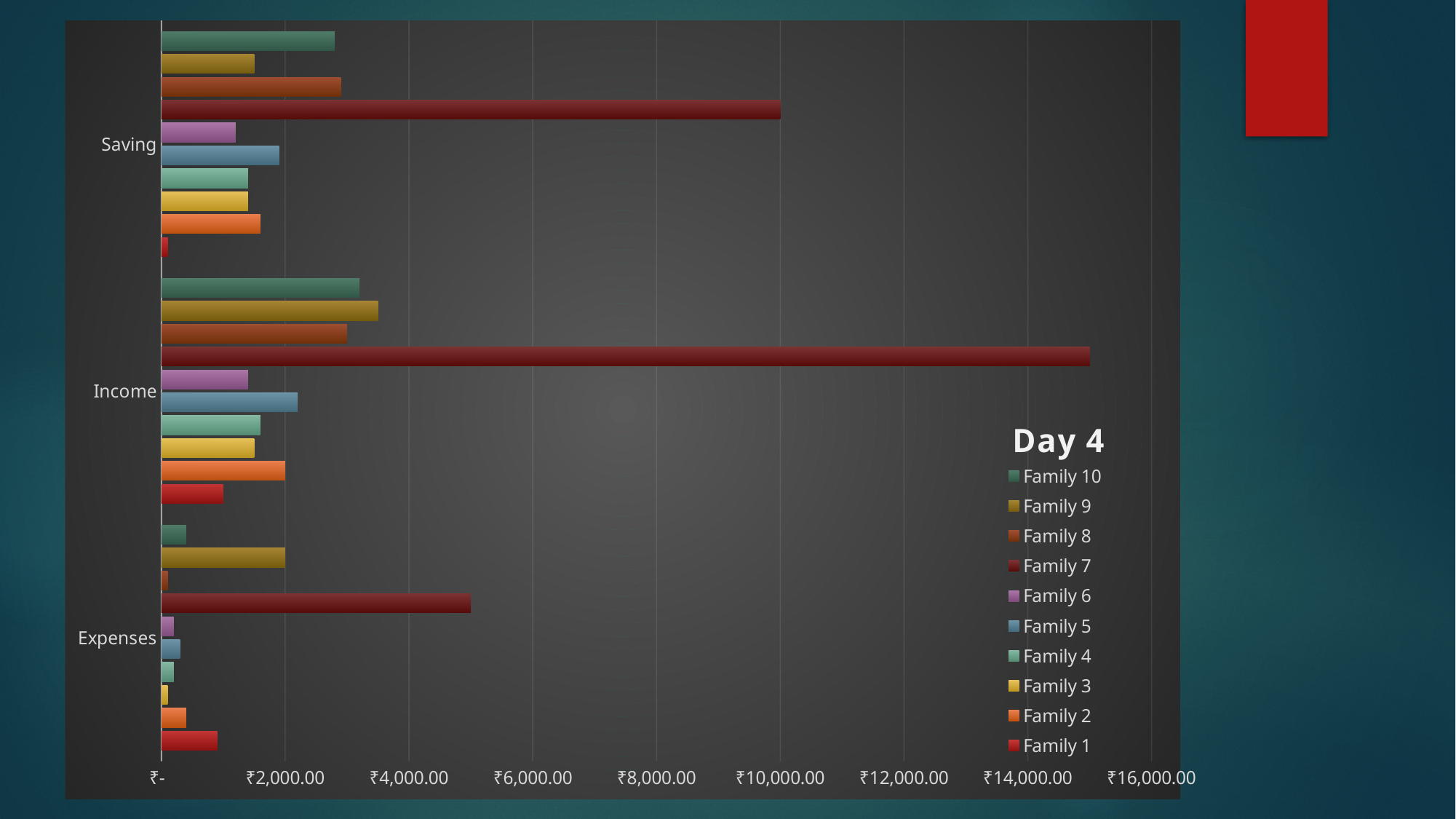
Is the Income value for Family 7 greater or less than ₹14,000.00? greater Which is larger, the Expenses of Family 1 or the Expenses of Family 2? Family 1 Which is larger, the Income of Family 9 or the Income of Family 10? Family 9 What is the title of the chart? Day 4 What kind of chart is shown on the slide? bar chart How many categories are shown on the vertical axis of the chart? 3 How many series does the legend list? 10 Which family has the highest Saving? Family 7 Is the Expenses value for Family 7 greater or less than ₹4,000.00? greater Which family has the lowest Saving? Family 1 Which family has the highest Income? Family 7 Which family has the highest Expenses? Family 7